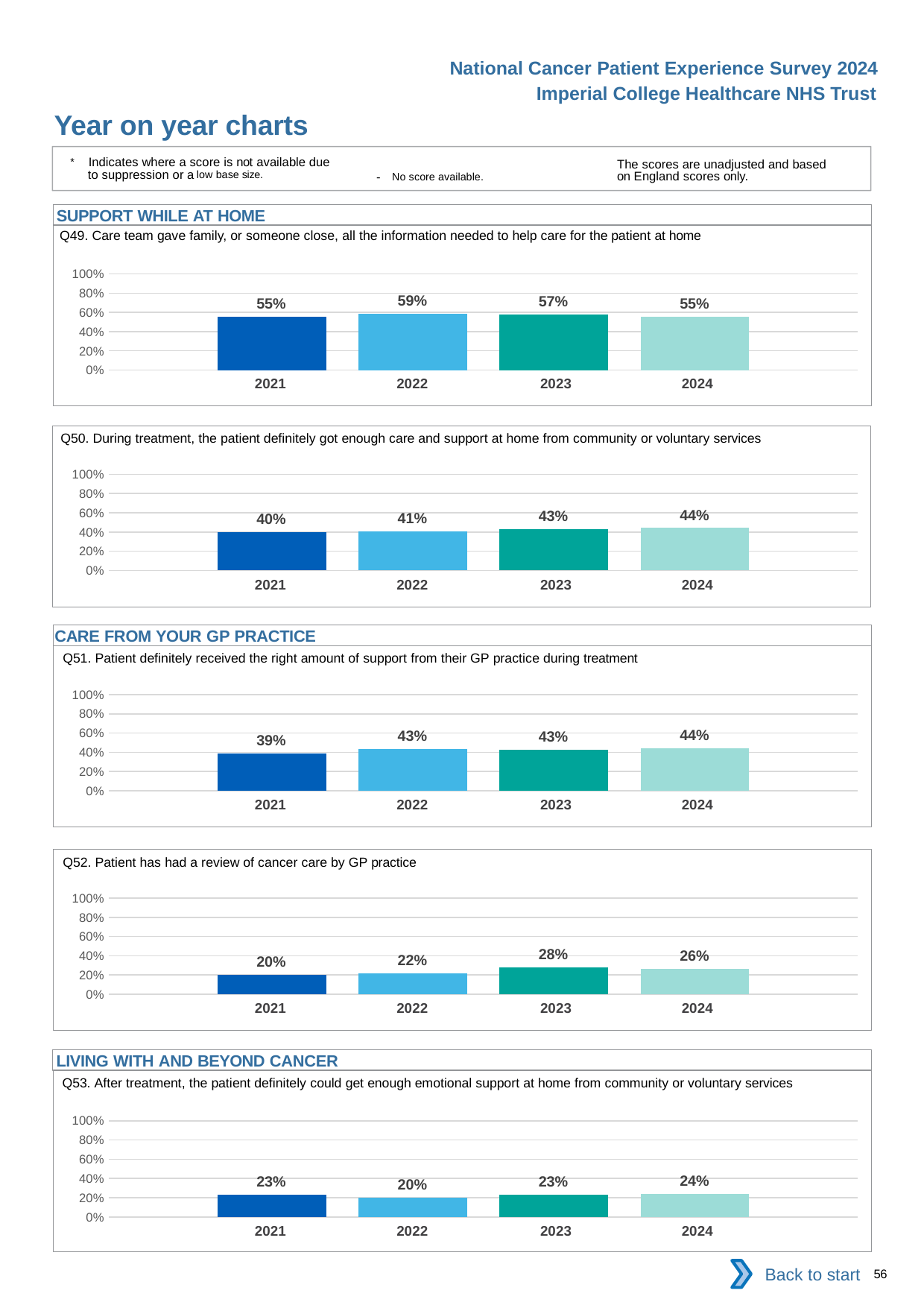
In the Q53 chart, what is the value for 2022? 20% In the Q51 chart, what is the value for 2021? 39% In the Q52 chart, is the value for 2023 larger or smaller than the value for 2024? larger In the Q50 chart, what is the difference between the 2024 and 2021 values? 4 percentage points What kind of chart is used for Q49? bar chart In the Q51 chart, which year has the lowest value? 2021 In the Q50 chart, do the values rise or fall from 2021 to 2024? rise In the Q52 chart, which year has the highest value? 2023 How many years are shown in the Q53 chart? 4 In the Q49 chart, what is the value for 2022? 59% In the Q50 chart, what is the value for 2024? 44% In the Q49 chart, which year has the highest value? 2022